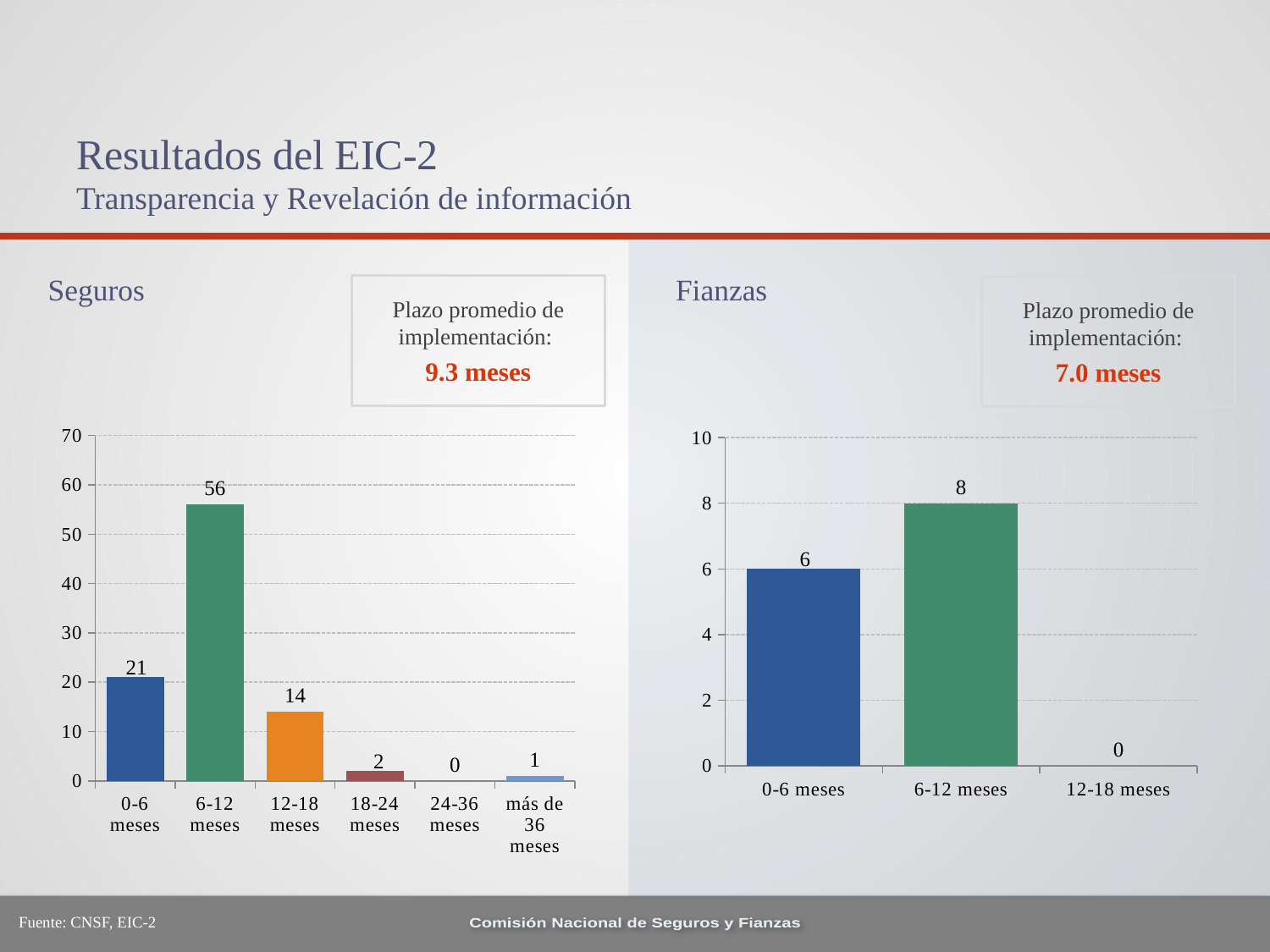
In the Fianzas chart, which category has the lowest value? 12-18 meses In the Seguros chart, what is the value for 0-6 meses? 21 In the Seguros chart, what is the value for 6-12 meses? 56 In the Seguros chart, which category has the highest value? 6-12 meses In the Fianzas chart, which is larger, the value for 0-6 meses or 6-12 meses? 6-12 meses In the Fianzas chart, what is the value for 6-12 meses? 8 In the Seguros chart, which category has the lowest value? 24-36 meses What is the average implementation period (plazo promedio de implementación) shown for Seguros? 9.3 meses In the Seguros chart, what is the value for más de 36 meses? 1 In the Seguros chart, what is the difference between the values for 6-12 meses and 12-18 meses? 42 In the Seguros chart, how many categories are shown on the x axis? 6 What kind of chart is the Fianzas chart? bar chart